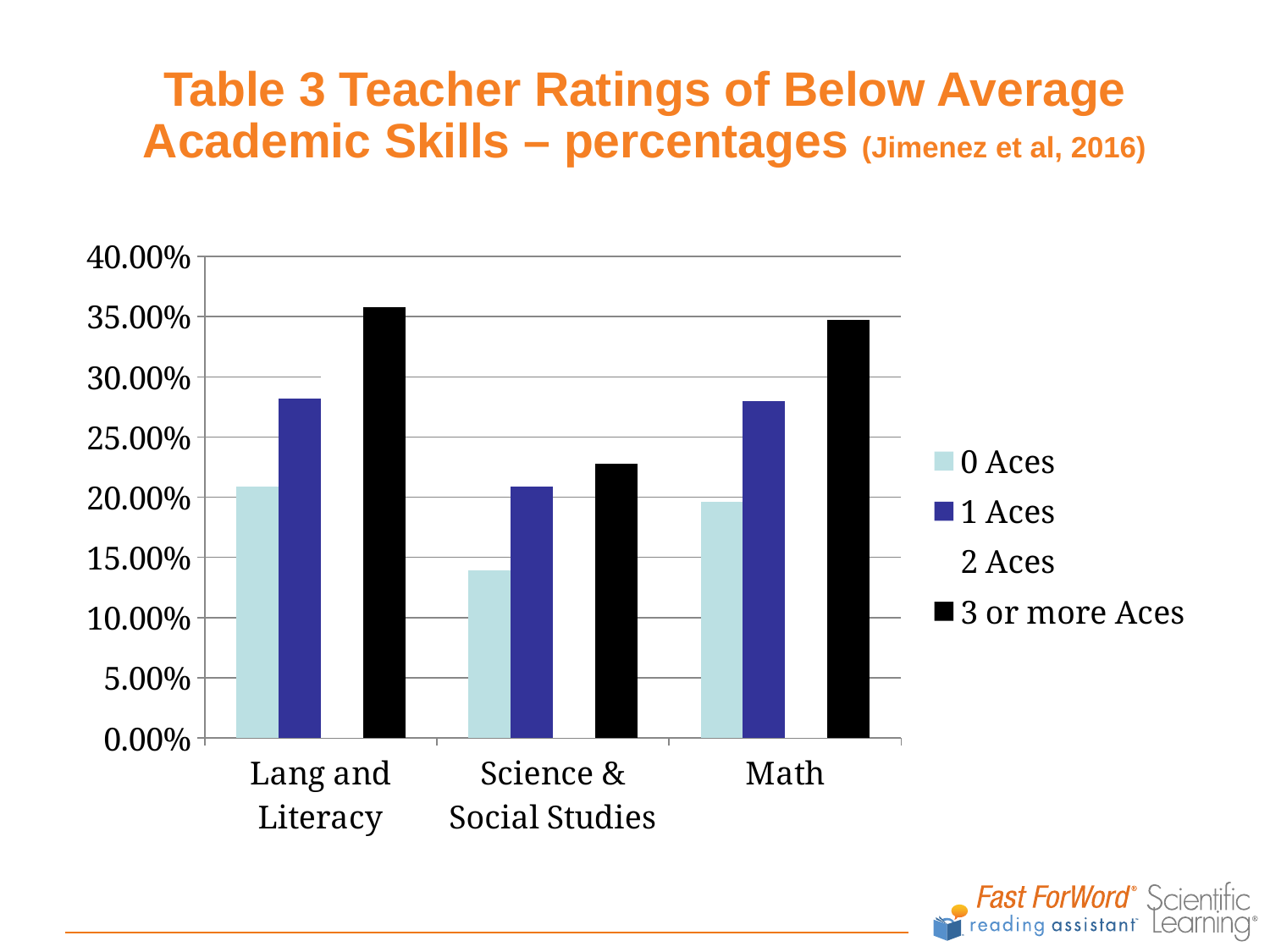
What kind of chart is shown on the slide? bar chart Is the value for 3 or more Aces in Lang and Literacy greater or less than 30.00%? greater Which is larger: the 3 or more Aces value for Math or the 3 or more Aces value for Science & Social Studies? Math Within the Lang and Literacy category, which series has the highest value? 3 or more Aces Is the value for 0 Aces in Science & Social Studies greater or less than 15.00%? less Is the value for 1 Aces in Math greater or less than 25.00%? greater How many series does the legend list? 4 Which is larger: the 0 Aces value for Lang and Literacy or the 0 Aces value for Science & Social Studies? Lang and Literacy How many categories are shown on the x axis? 3 Which category has the lowest value for 0 Aces? Science & Social Studies What is the title of the chart? Table 3 Teacher Ratings of Below Average Academic Skills – percentages (Jimenez et al, 2016)